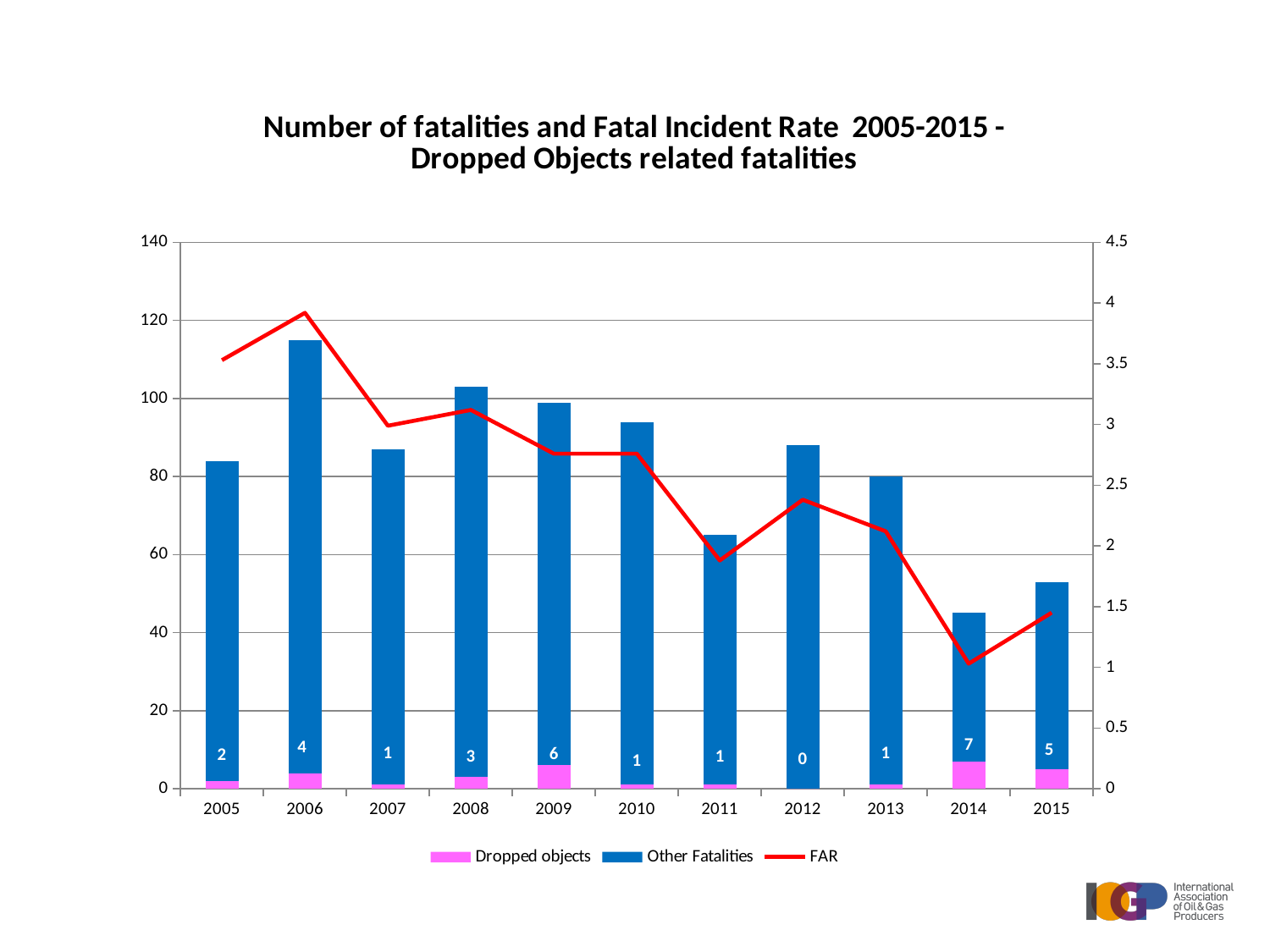
Is the total number of fatalities in 2006 greater or less than 100? greater What is the number of Dropped objects fatalities in 2012? 0 Which year has more Dropped objects fatalities, 2006 or 2008? 2006 Does the FAR line generally rise or fall from 2006 to 2014? fall Which year has the lowest number of Dropped objects fatalities? 2012 What is the difference between the Dropped objects fatalities in 2014 and in 2015? 2 What is the number of Dropped objects fatalities in 2009? 6 Which year has the highest number of Dropped objects fatalities? 2014 What is the number of Dropped objects fatalities in 2014? 7 How many series does the legend list? 3 How many years are shown on the x axis? 11 Is the total number of fatalities in 2014 greater or less than 60? less